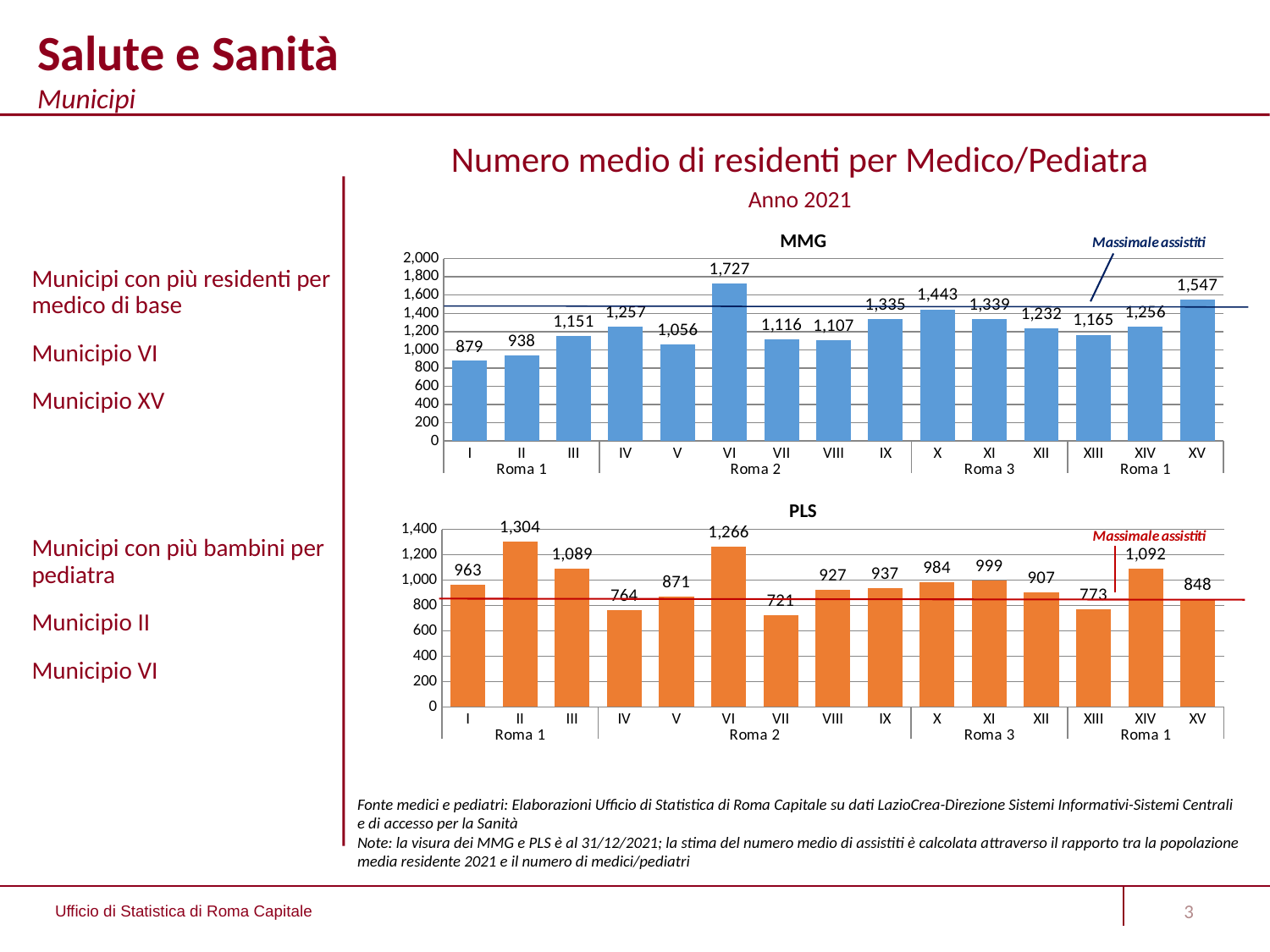
How many municipi are shown in the PLS chart? 15 In the PLS chart, what is the value for Municipio VII? 721 In the MMG chart, which is larger, the value for Municipio X or the value for Municipio XI? Municipio X In the MMG chart, what is the value for Municipio XIII? 1,165 In the MMG chart, what is the difference between the values for Municipio XV and Municipio I? 668 In the MMG chart, which municipio has the lowest value? I In the PLS chart, is the value for Municipio XIV greater or less than 1,000? greater In the PLS chart, what is the difference between the values for Municipio II and Municipio IV? 540 In the PLS chart, which municipio has the highest value? II What type of chart is the MMG chart? bar chart In the MMG chart, what is the value for Municipio VI? 1,727 What is the title of the top chart on the slide? MMG